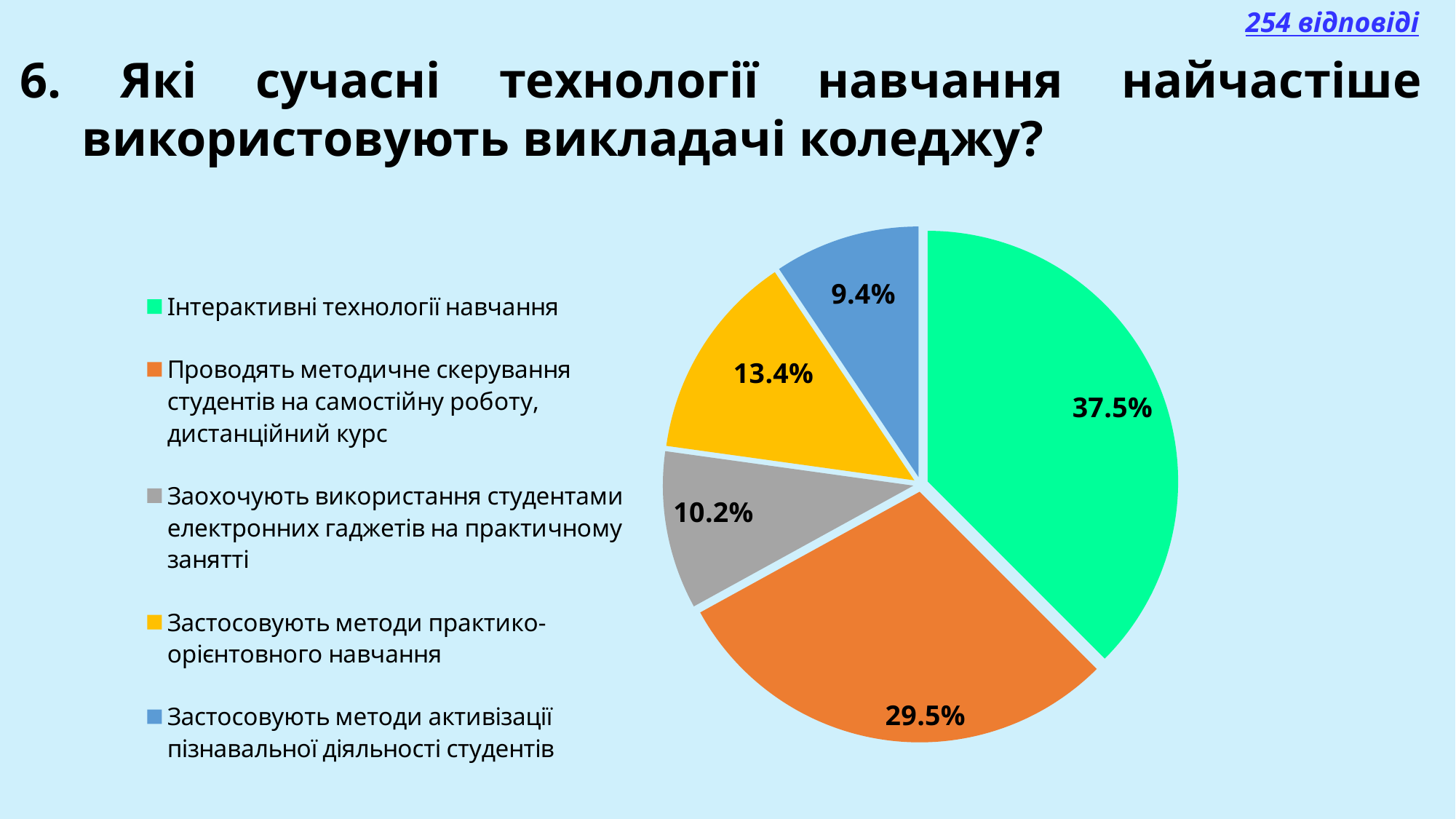
What is the difference in percentage points between the "Інтерактивні технології навчання" slice and the "Проводять методичне скерування студентів на самостійну роботу, дистанційний курс" slice? 8 percentage points What percentage is shown for "Заохочують використання студентами електронних гаджетів на практичному занятті"? 10.2% What percentage is shown for "Проводять методичне скерування студентів на самостійну роботу, дистанційний курс"? 29.5% How many slices does the pie chart have? 5 What percentage is shown for "Застосовують методи практико-орієнтовного навчання"? 13.4% What type of chart is shown on the slide? pie chart What colour is the slice for "Застосовують методи активізації пізнавальної діяльності студентів"? blue What percentage is shown for "Застосовують методи активізації пізнавальної діяльності студентів"? 9.4% Which category has the largest slice of the pie? Інтерактивні технології навчання Which category has the smallest slice of the pie? Застосовують методи активізації пізнавальної діяльності студентів Which is larger: the slice for "Застосовують методи практико-орієнтовного навчання" or the slice for "Заохочують використання студентами електронних гаджетів на практичному занятті"? Застосовують методи практико-орієнтовного навчання What share of the pie is labelled for "Інтерактивні технології навчання"? 37.5%